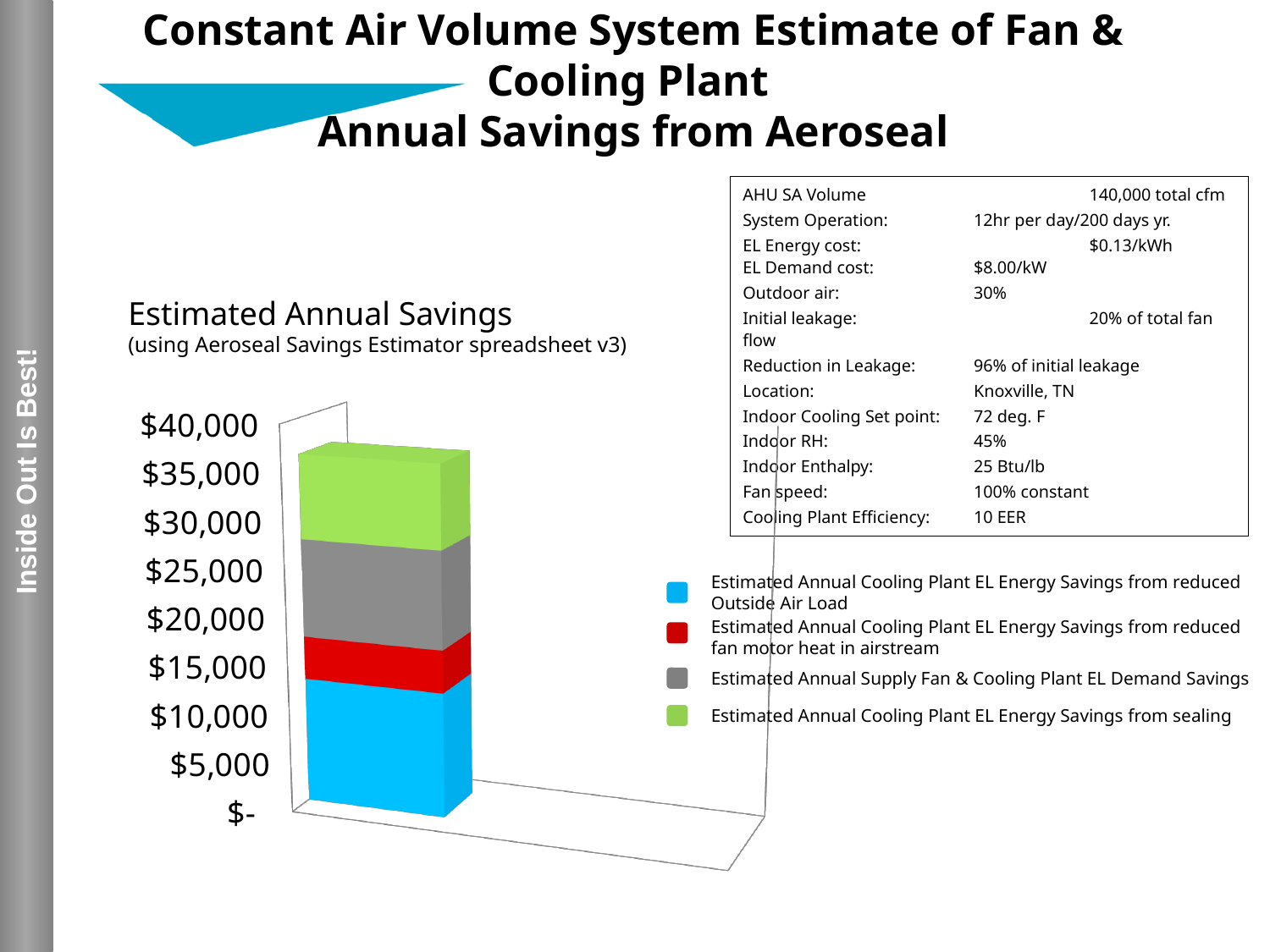
Which segment is larger: the blue segment (reduced Outside Air Load) or the red segment (reduced fan motor heat in airstream)? The blue segment (reduced Outside Air Load) Is the value of the blue segment (Estimated Annual Cooling Plant EL Energy Savings from reduced Outside Air Load) greater or less than $10,000? greater How many bars are plotted in the chart? 1 Is the total height of the stacked bar greater or less than $30,000? greater Is the value of the red segment (Estimated Annual Cooling Plant EL Energy Savings from reduced fan motor heat in airstream) greater or less than $10,000? less What kind of chart is shown on the slide? Stacked bar chart Which series contributes the smallest segment to the stacked bar? Estimated Annual Cooling Plant EL Energy Savings from reduced fan motor heat in airstream Which legend entry is shown in green? Estimated Annual Cooling Plant EL Energy Savings from sealing Which segment is larger: the red segment (reduced fan motor heat in airstream) or the green segment (savings from sealing)? The green segment (savings from sealing) What is the title of the chart? Estimated Annual Savings How many series does the chart's legend list? 4